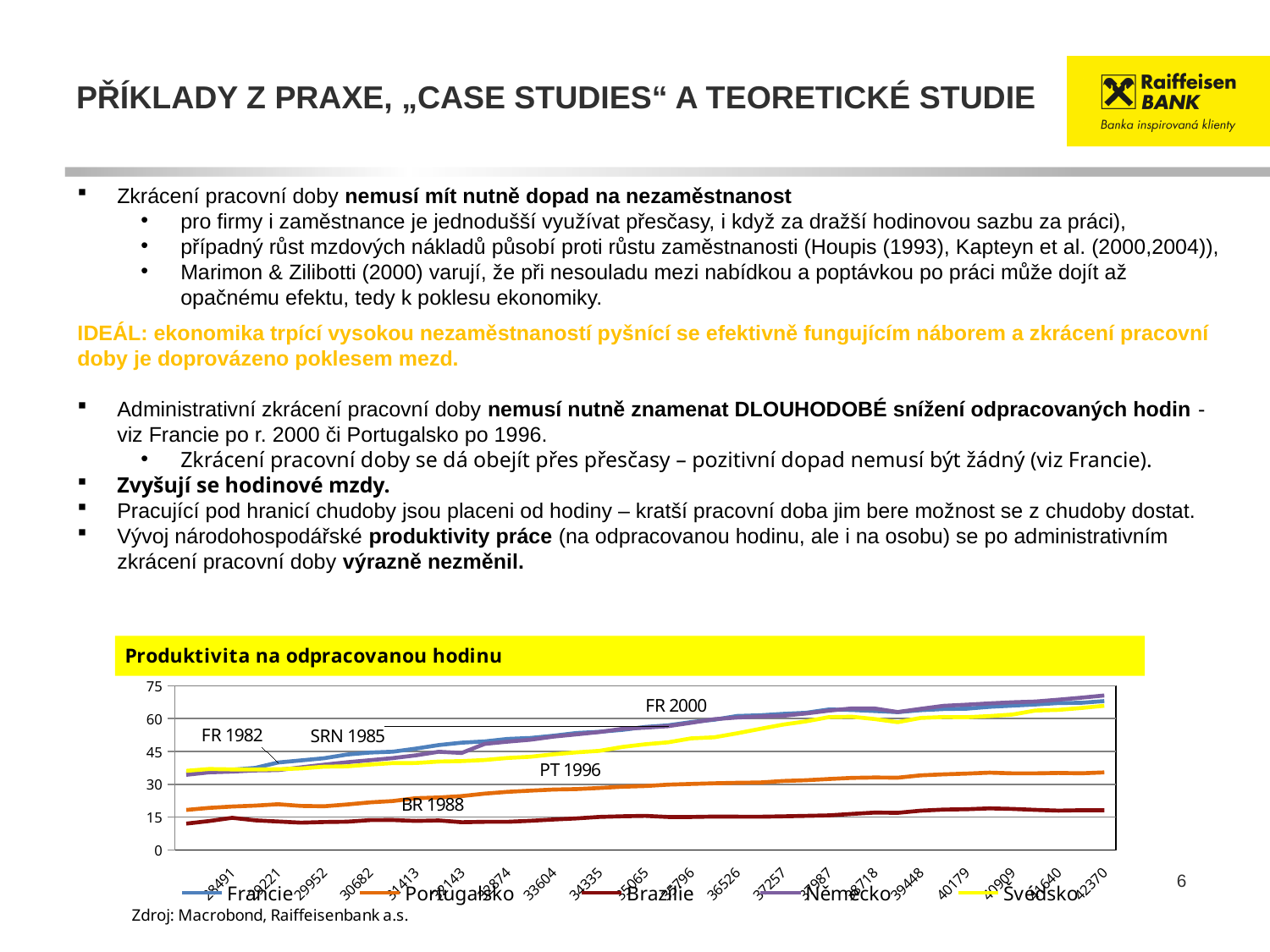
Which series has higher values at the right end of the chart, Švédsko or Portugalsko? Švédsko What kind of chart is shown under the title "Produktivita na odpracovanou hodinu"? line chart Which series has the lowest values across the whole chart? Brazílie How many series does the legend of the chart list? 5 Does the Francie series rise or fall from left to right along the x axis? rise What is the title of the chart on the slide? Produktivita na odpracovanou hodinu Is the value for Švédsko at the left end of the chart greater or less than 45? less Which series has higher values at the right end of the chart, Portugalsko or Brazílie? Portugalsko Which source is cited below the chart? Macrobond, Raiffeisenbank a.s. Is the value for Portugalsko at the right end of the chart greater or less than 30? greater Is the value for Brazílie at the right end of the chart greater or less than 30? less